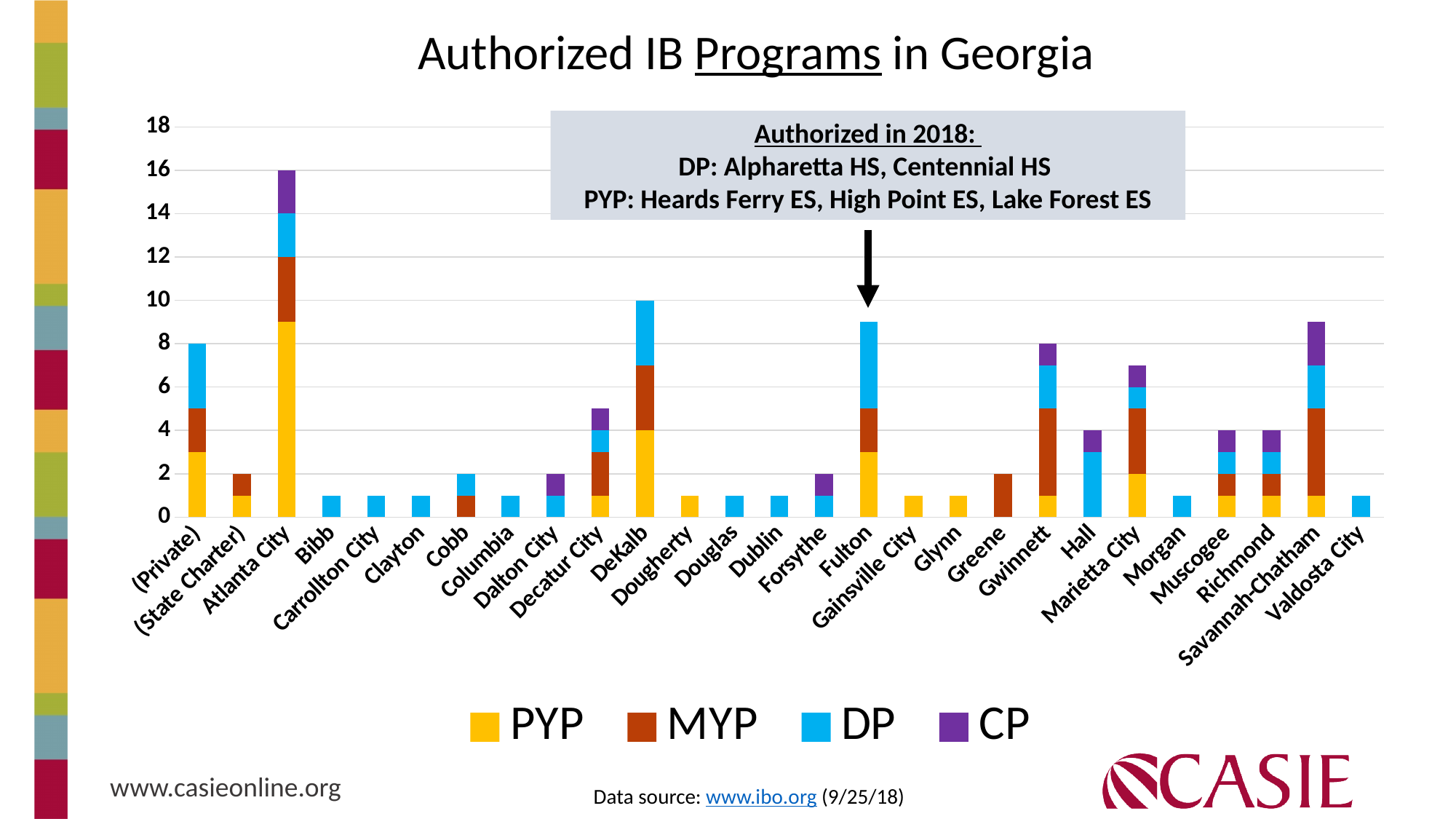
Which has a larger total, DeKalb or Gwinnett? DeKalb Which series are listed in the legend? PYP, MYP, DP, CP Is the total value for Fulton greater or less than 8? greater How many series does the legend list? 4 Is the total value for Marietta City greater or less than 8? less What is the total height of the stacked bar for Atlanta City? 16 What is the title of the chart? Authorized IB Programs in Georgia How many districts/categories are shown on the x axis? 27 Which category has the highest total number of authorized IB programs? Atlanta City What is the difference between the total for Atlanta City and the total for DeKalb? 6 What is the total height of the stacked bar for DeKalb? 10 What kind of chart is shown on the slide? Stacked bar chart